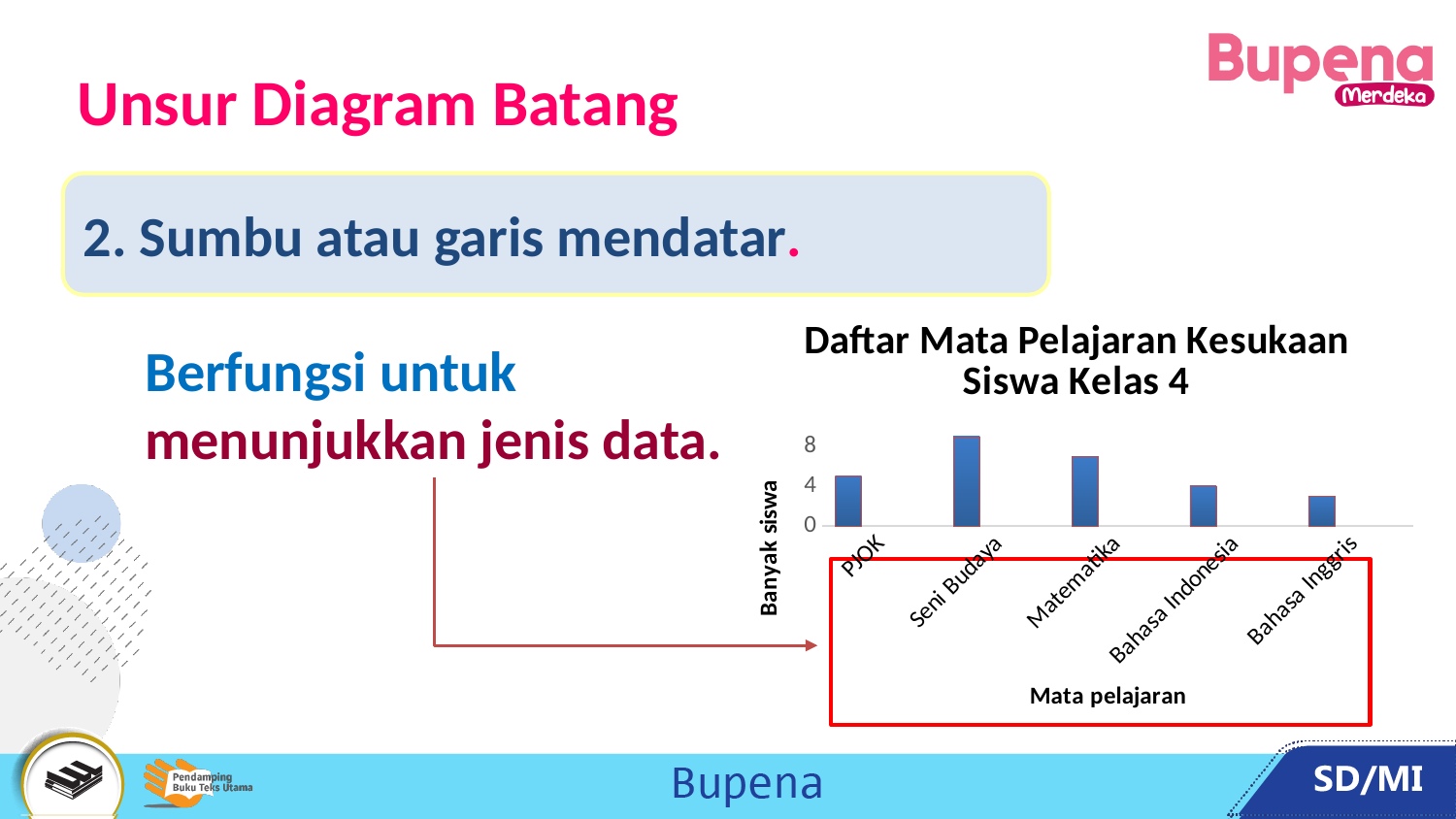
What type of chart is shown on the slide? bar chart What is the label of the vertical axis of the chart? Banyak siswa Is the value for PJOK greater or less than 4? greater How many subjects (categories) are shown on the chart? 5 Which is larger, the value for Seni Budaya or the value for Bahasa Inggris? Seni Budaya Which is larger, the value for Matematika or the value for PJOK? Matematika What is the title of the chart? Daftar Mata Pelajaran Kesukaan Siswa Kelas 4 Which subject has the lowest bar? Bahasa Inggris Is the value for Bahasa Inggris greater or less than 4? less Which subject has the highest bar? Seni Budaya Is the value for Seni Budaya greater or less than 4? greater